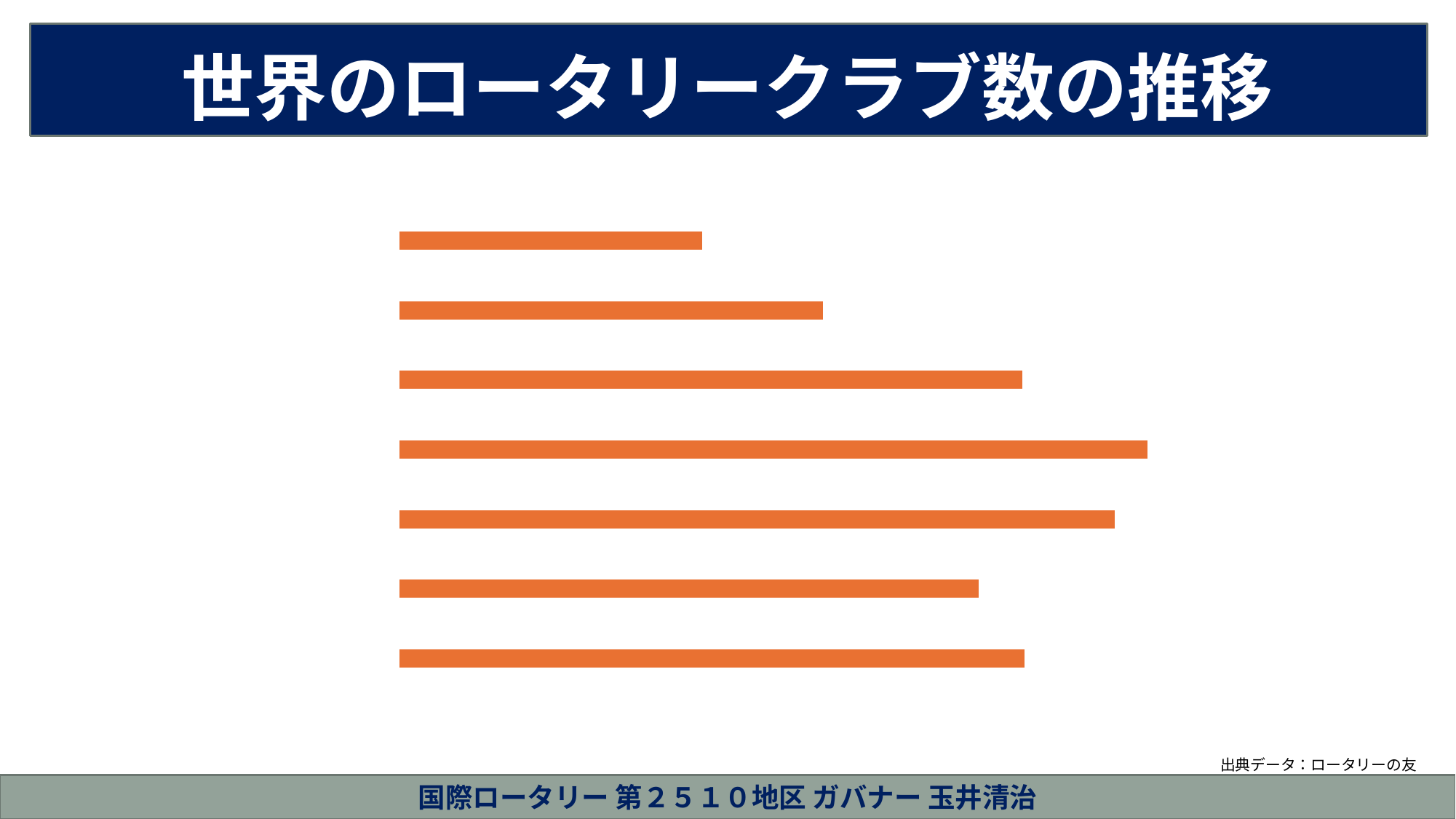
Which is longer, the 4th bar from the top or the 5th bar from the top? the 4th bar from the top Which is longer, the 2nd bar from the top or the 3rd bar from the top? the 3rd bar from the top How many bars does the chart contain? 7 Which bar is the longest: counting from the top, which position is it? the 4th bar from the top Which is longer, the 6th bar from the top or the bottom bar? the bottom bar Which bar is the shortest in the chart? the top bar What is the title of the slide containing the chart? 世界のロータリークラブ数の推移 Do the bars get longer or shorter going from the top bar to the 4th bar? longer Do the bars get longer or shorter going from the 4th bar to the 6th bar? shorter What kind of chart is shown on the slide? bar chart What colour are the bars in the chart? orange